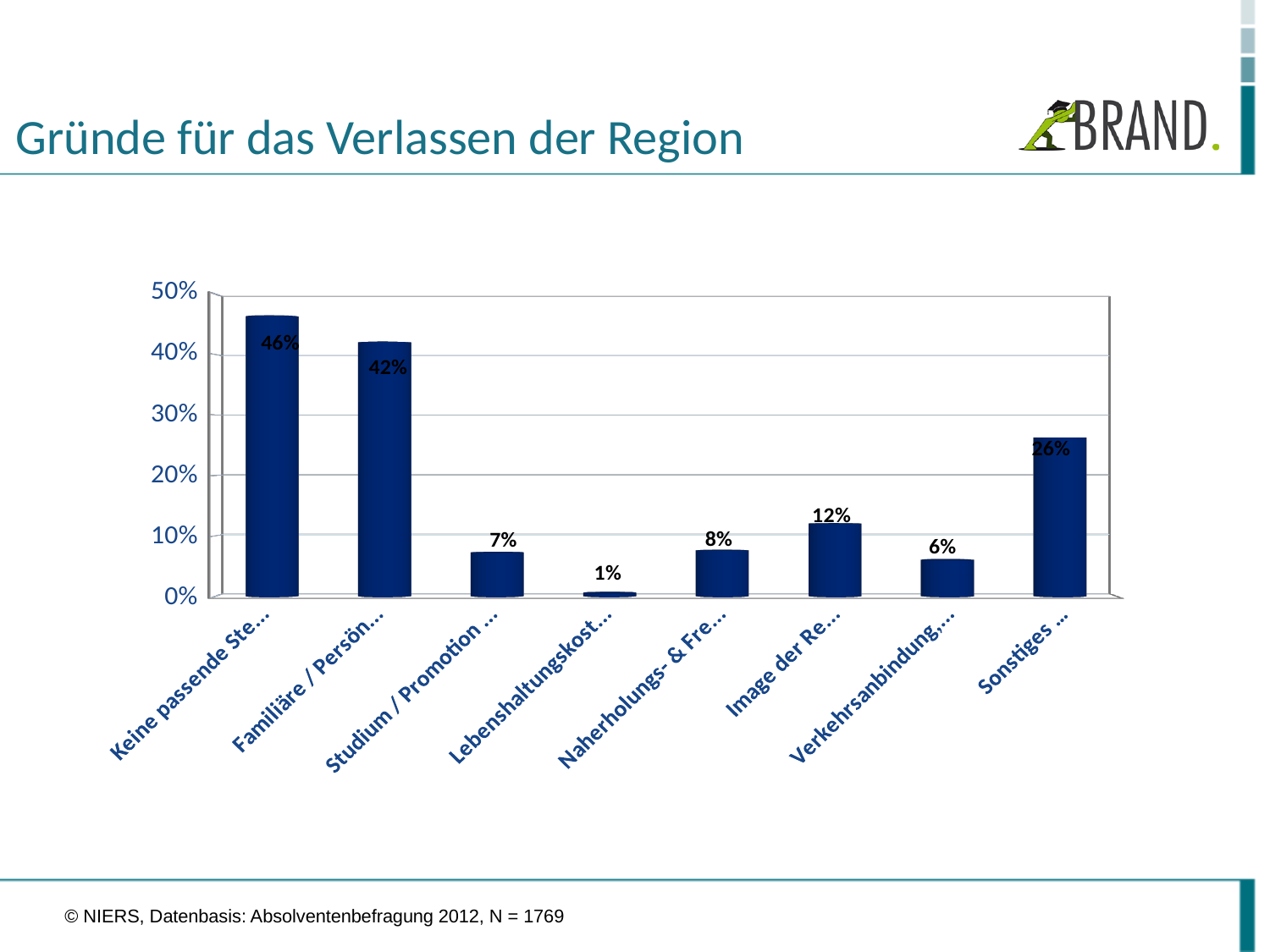
What is the difference between the values for "Sonstiges ..." and "Image der Re..."? 14% Which category has the lowest value in the chart? Lebenshaltungskost... Which category has the highest value in the chart? Keine passende Ste... Is the value for "Familiäre / Persön..." greater or less than 40%? greater What value is shown for the bar labelled "Keine passende Ste..."? 46% What is the title of the slide containing the chart? Gründe für das Verlassen der Region What value is shown for the bar labelled "Sonstiges ..."? 26% What value is shown for the bar labelled "Image der Re..."? 12% What kind of chart is shown on the slide? bar chart What is the difference between the values for "Keine passende Ste..." and "Familiäre / Persön..."? 4% Which is larger, the value for "Naherholungs- & Fre..." or the value for "Verkehrsanbindung,..."? Naherholungs- & Fre... How many categories are shown in the chart? 8